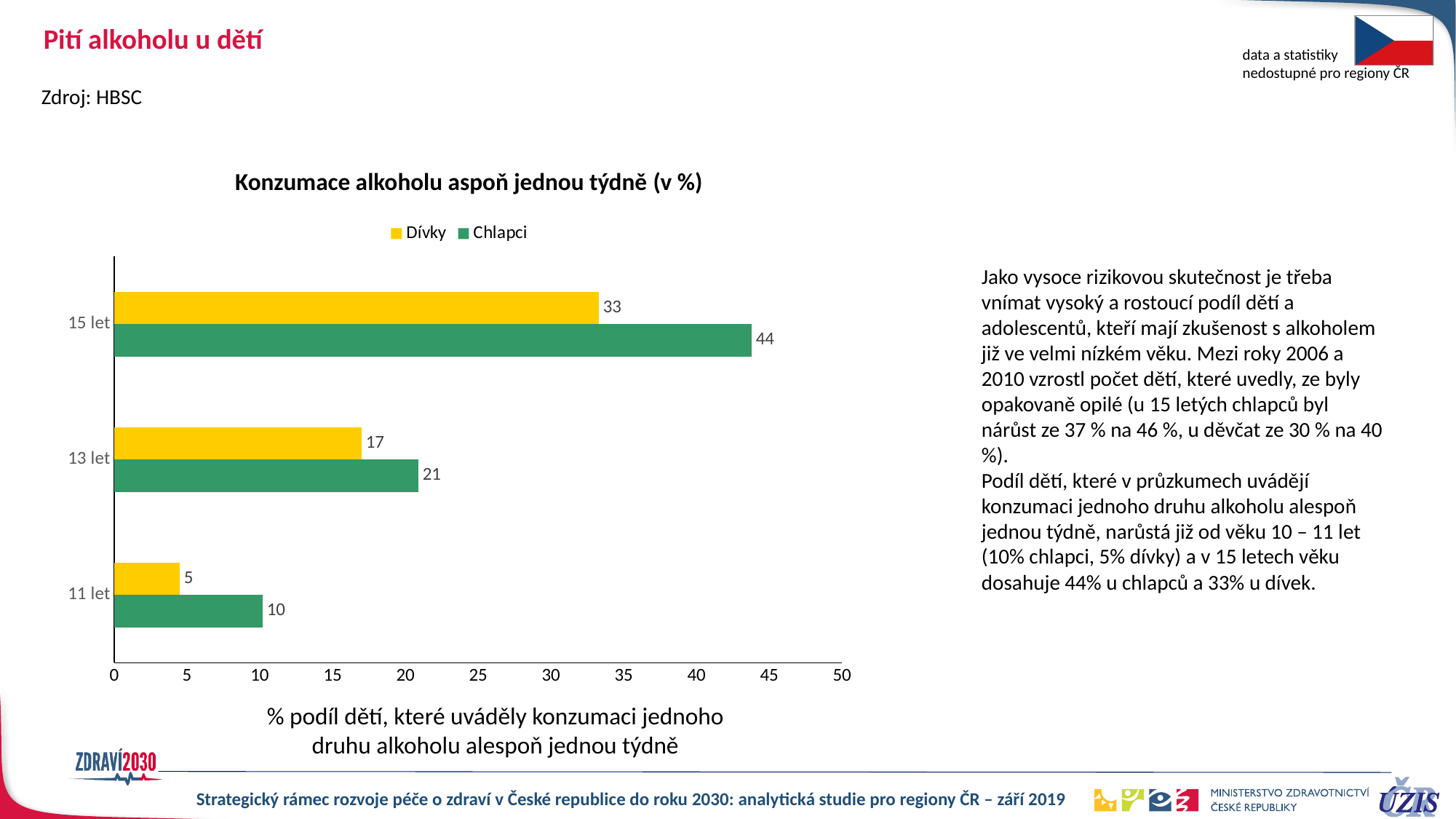
How many series does the legend list? 2 Which is larger at 13 let, Dívky or Chlapci? Chlapci What is the difference between Chlapci and Dívky at 15 let? 11 Which age group has the lowest value for Dívky? 11 let What kind of chart is shown? bar chart How many age groups are shown on the chart? 3 What is the title of the chart? Konzumace alkoholu aspoň jednou týdně (v %) What is the value for Dívky at 11 let? 5 What is the difference between Chlapci at 13 let and Chlapci at 11 let? 11 What is the value for Dívky at 15 let? 33 What is the value for Chlapci at 13 let? 21 Which age group has the highest value for Chlapci? 15 let